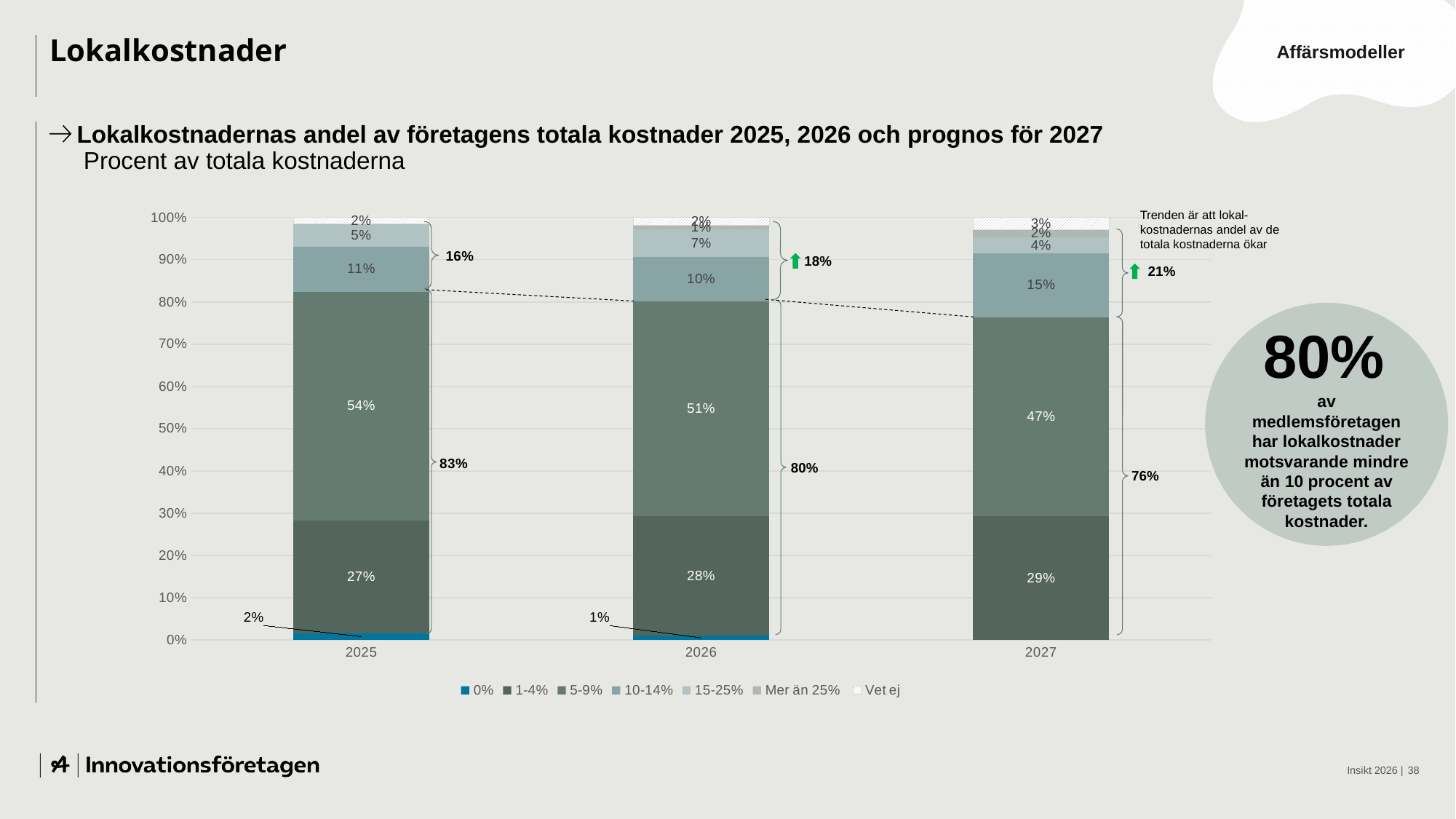
What kind of chart is shown on the slide? Stacked bar chart How many series does the legend list? 7 Which year has the largest 5-9% segment? 2025 Is the 10-14% segment larger in 2027 or in 2026? 2027 Does the 5-9% segment rise or fall from 2025 to 2027? Fall What is the value of the 5-9% segment for 2025? 54% What is the value of the 15-25% segment for 2027? 4% What is the value of the 10-14% segment for 2026? 10% Which year has the smallest 10-14% segment? 2026 How many years (categories) are shown on the x axis? 3 What is the value of the 1-4% segment for 2027? 29% What is the difference between the 5-9% segment in 2025 and in 2027? 7 percentage points